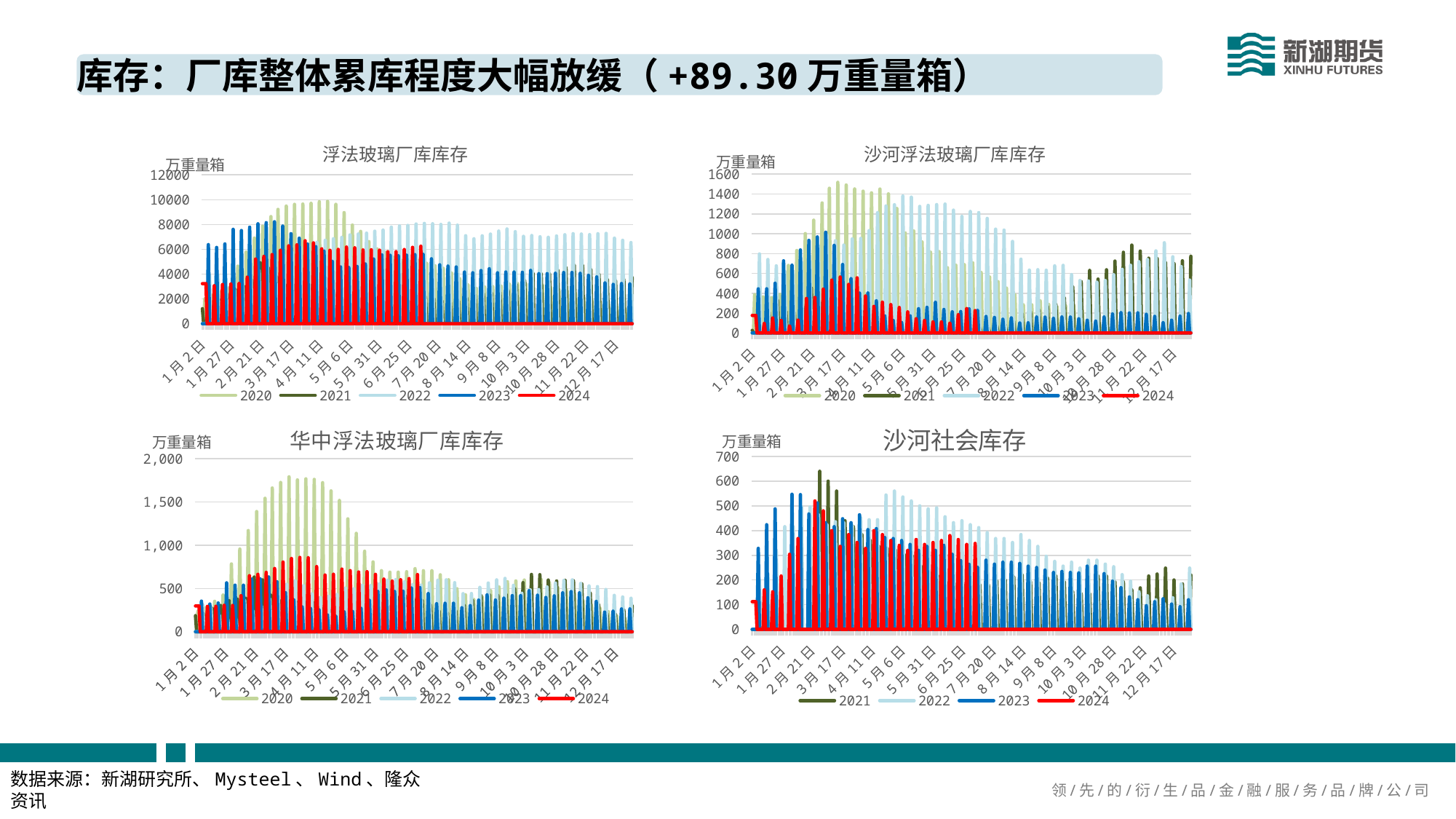
What unit is shown on the y axis of the 沙河社会库存 chart? 万重量箱 In the 华中浮法玻璃厂库库存 chart, is the peak value of the 2020 series greater or less than 1,500? greater In the 沙河浮法玻璃厂库库存 chart, which year's series reaches the highest peak? 2020 In the 沙河社会库存 chart, how many series does the legend list? 4 In the 浮法玻璃厂库库存 chart, how many series does the legend list? 5 In the 浮法玻璃厂库库存 chart, which year's series reaches the highest peak? 2020 How many charts are shown on the slide? 4 In the 华中浮法玻璃厂库库存 chart, is the peak value of the 2024 series greater or less than 1,000? less In the 浮法玻璃厂库库存 chart, is the peak value of the 2020 series greater or less than 8000? greater In the 沙河社会库存 chart, which year's series reaches the highest peak? 2021